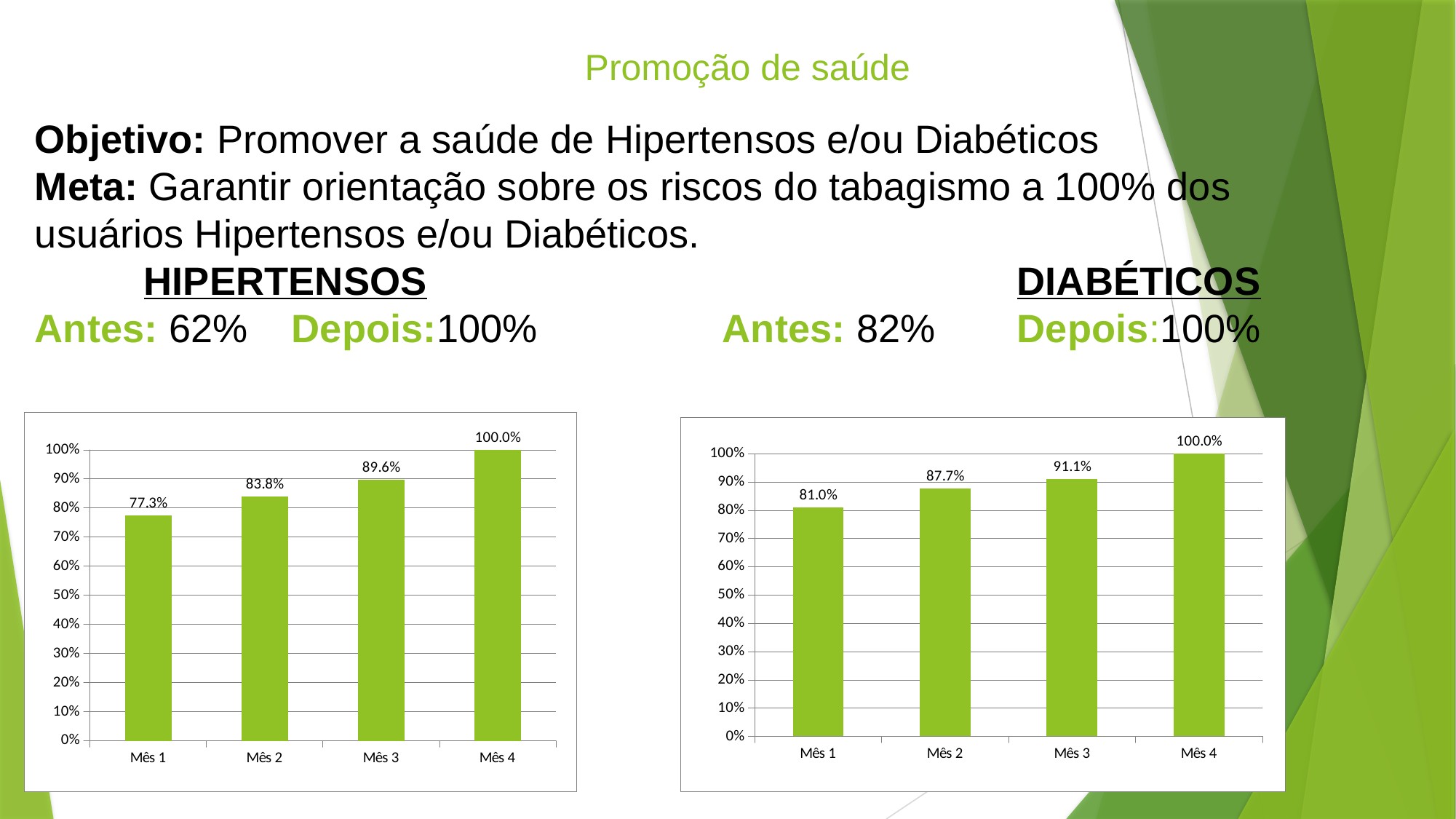
In the right chart (Diabéticos), which month has the lowest value? Mês 1 Which is larger: the Mês 1 value in the left chart (Hipertensos) or the Mês 1 value in the right chart (Diabéticos)? Right chart (Diabéticos), 81.0% In the right chart (Diabéticos), do the values rise or fall from Mês 1 to Mês 4? Rise In the left chart (Hipertensos), what is the value for Mês 1? 77.3% In the left chart (Hipertensos), what is the difference between the values for Mês 4 and Mês 1? 22.7% In the left chart (Hipertensos), is the value for Mês 2 greater or less than 80%? greater In the left chart (Hipertensos), what is the value for Mês 3? 89.6% What kind of chart is the left chart (Hipertensos)? Bar chart In the right chart (Diabéticos), what is the value for Mês 2? 87.7% In the right chart (Diabéticos), what is the difference between the values for Mês 3 and Mês 2? 3.4% How many bars are plotted in the right chart (Diabéticos)? 4 In the left chart (Hipertensos), which month has the highest value? Mês 4